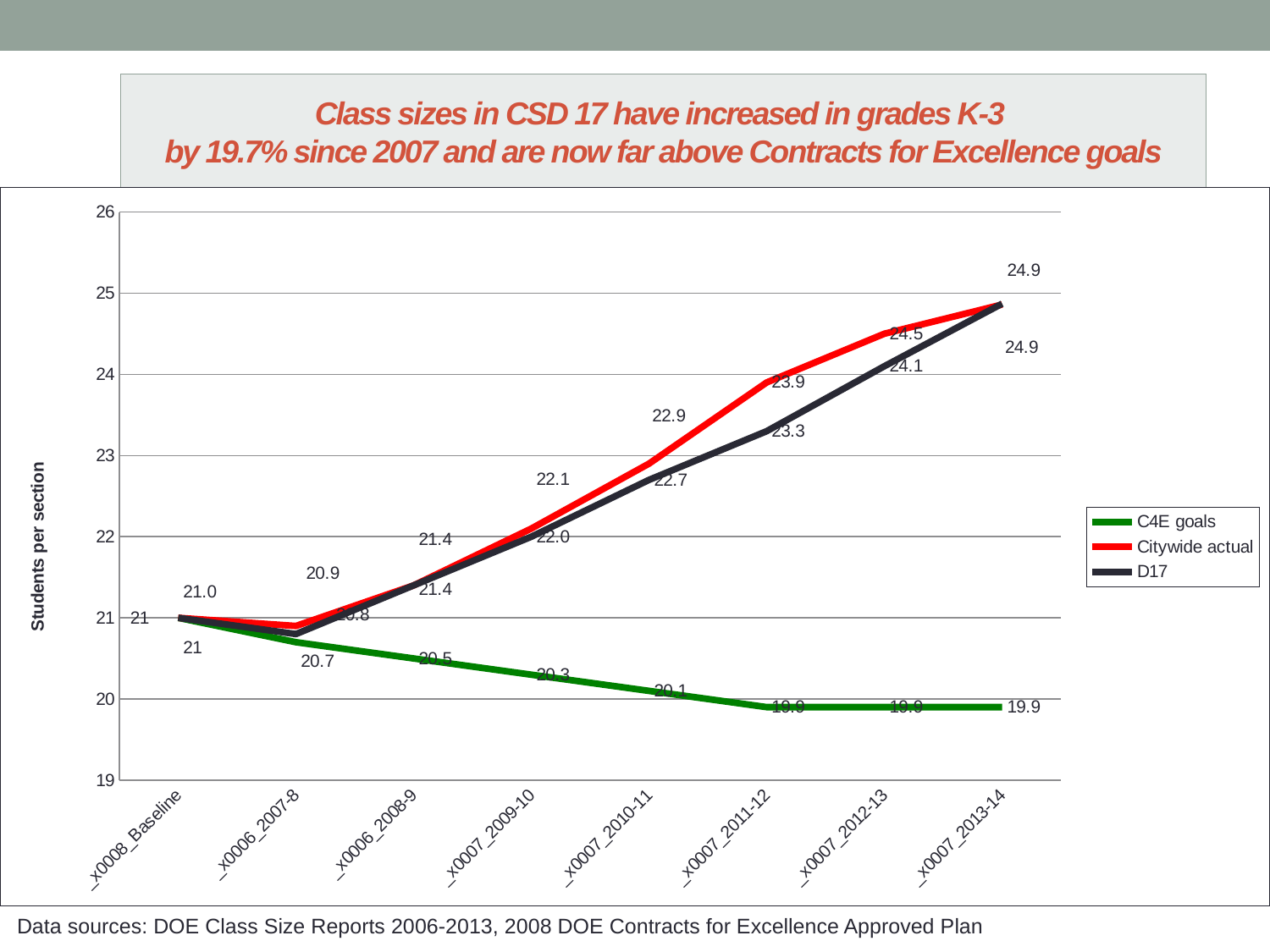
What is the C4E goals value for 2013-14? 19.9 What is the Citywide actual value for 2013-14? 24.9 What is the Citywide actual value for 2010-11? 22.9 What is the difference between the Citywide actual and D17 values in 2011-12? 0.6 How many series does the legend list? 3 What type of chart is shown on the slide? line chart In 2012-13, which is larger: Citywide actual or D17? Citywide actual Do the C4E goals values rise or fall from Baseline to 2013-14? fall How many points along the x axis does each line have? 8 What is the D17 value for 2011-12? 23.3 What is the y-axis title of the chart? Students per section At which x-axis point is the D17 line highest? 2013-14